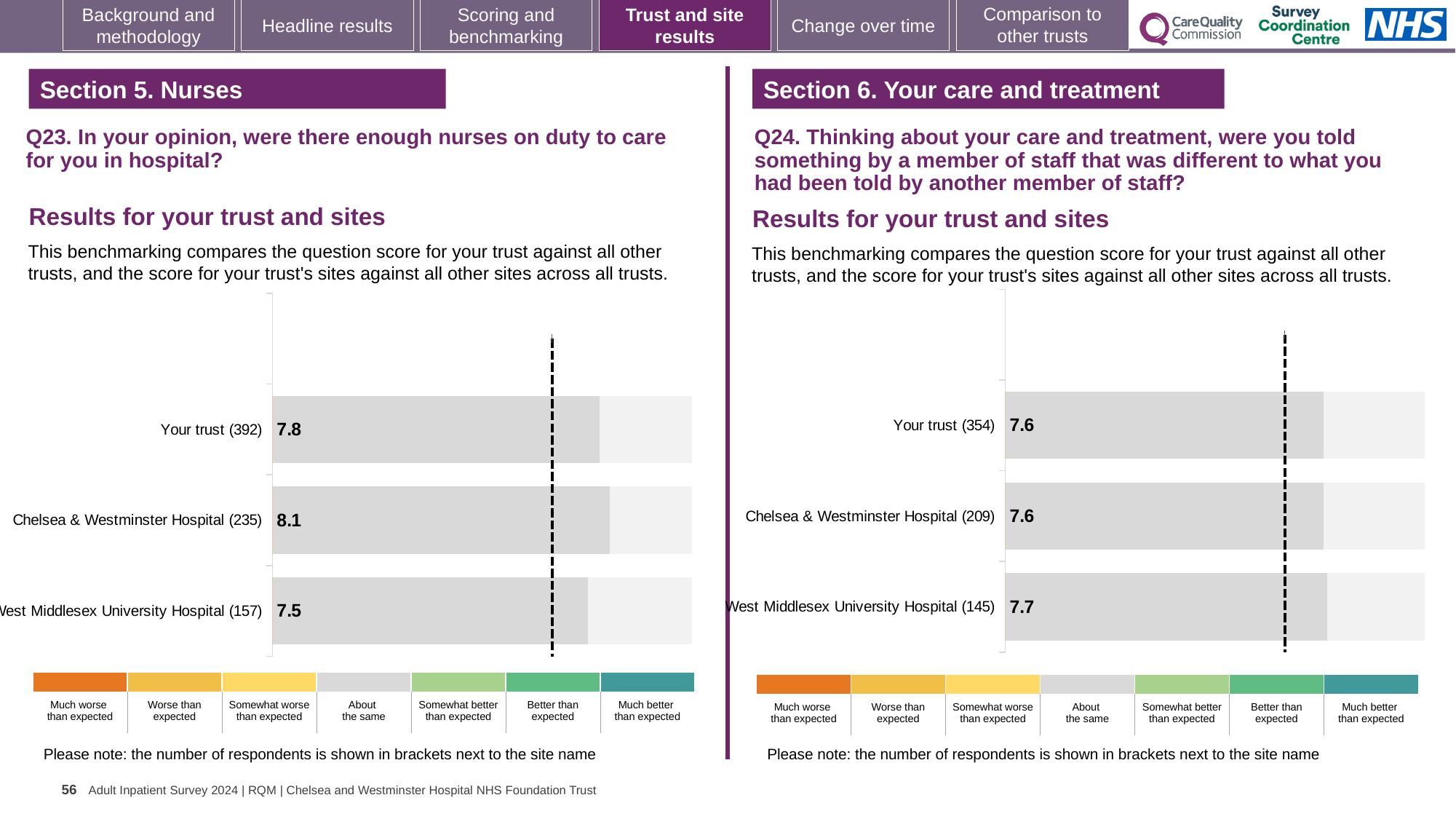
On the Q23 chart (enough nurses on duty), how many bars are plotted? 3 On the Q24 chart (told something different by staff), how many respondents are shown in brackets for Chelsea & Westminster Hospital? 209 On the Q23 chart (enough nurses on duty), which site or trust has the lowest score? West Middlesex University Hospital (157) What type of chart is used on the Q24 chart (told something different by staff)? Bar chart On the Q23 chart (enough nurses on duty), what is the score for Your trust (392)? 7.8 On the Q23 chart (enough nurses on duty), what is the score for West Middlesex University Hospital (157)? 7.5 On the Q24 chart (told something different by staff), what is the difference between the scores for West Middlesex University Hospital and Chelsea & Westminster Hospital? 0.1 On the Q24 chart (told something different by staff), what is the score for Your trust (354)? 7.6 On the Q23 chart (enough nurses on duty), what is the difference between the scores for Chelsea & Westminster Hospital and West Middlesex University Hospital? 0.6 On the Q23 chart (enough nurses on duty), which site or trust has the highest score? Chelsea & Westminster Hospital (235) On the Q24 chart (told something different by staff), what is the score for West Middlesex University Hospital (145)? 7.7 On the Q23 chart (enough nurses on duty), what is the score for Chelsea & Westminster Hospital (235)? 8.1